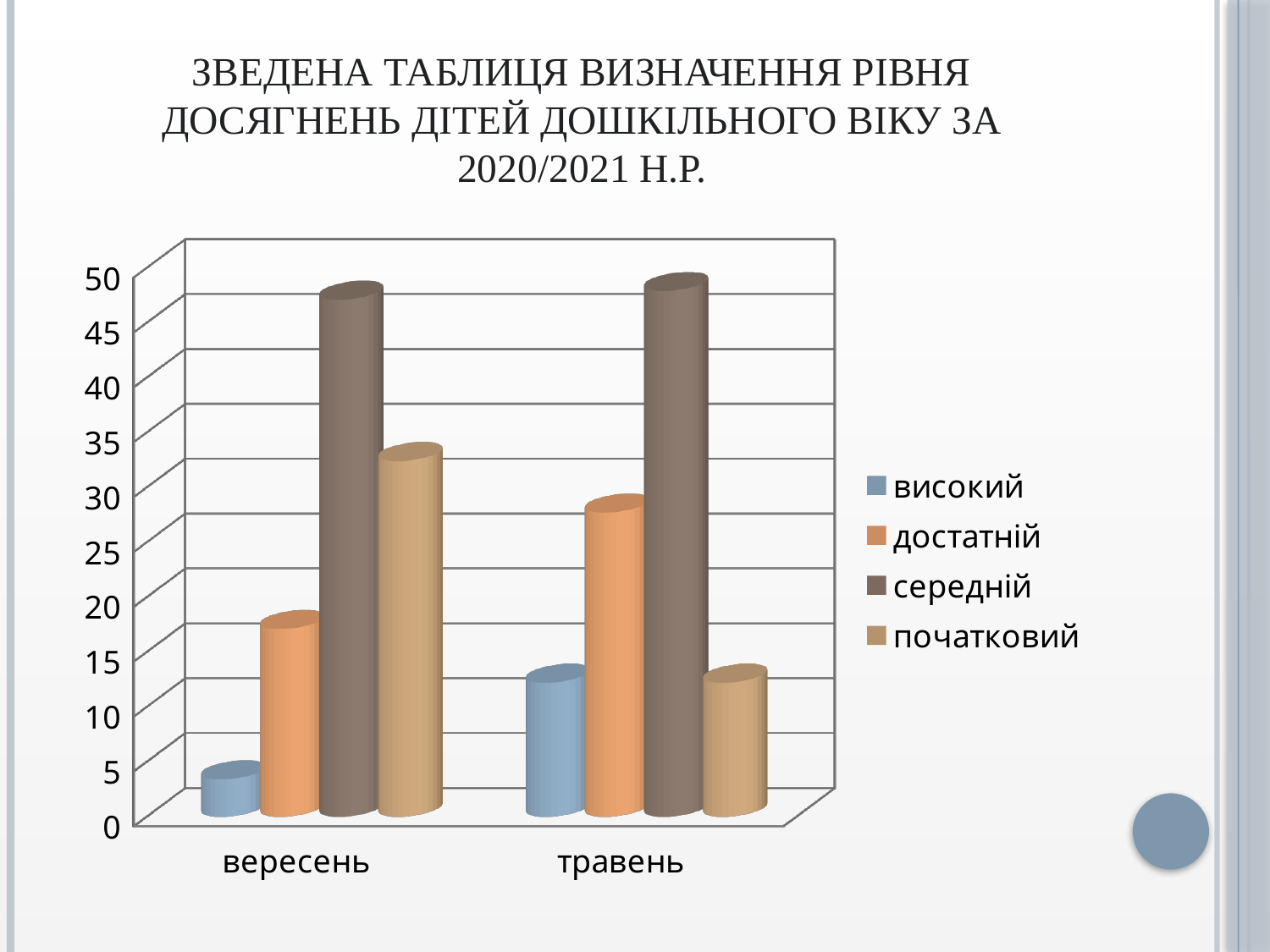
Which series has the highest value for травень? середній Which series has the lowest value for вересень? високий Is the value for достатній in травень greater or less than 20? greater How many series does the chart's legend list? 4 How many categories are shown on the x axis of the chart? 2 Does the value of високий rise or fall from вересень to травень? rise Is the value for високий in вересень greater or less than 10? less What kind of chart is shown on the slide? bar chart Is the value for середній in вересень greater or less than 40? greater Is the value of початковий larger for вересень or for травень? вересень Which series has the highest value for вересень? середній Is the value of достатній larger for вересень or for травень? травень